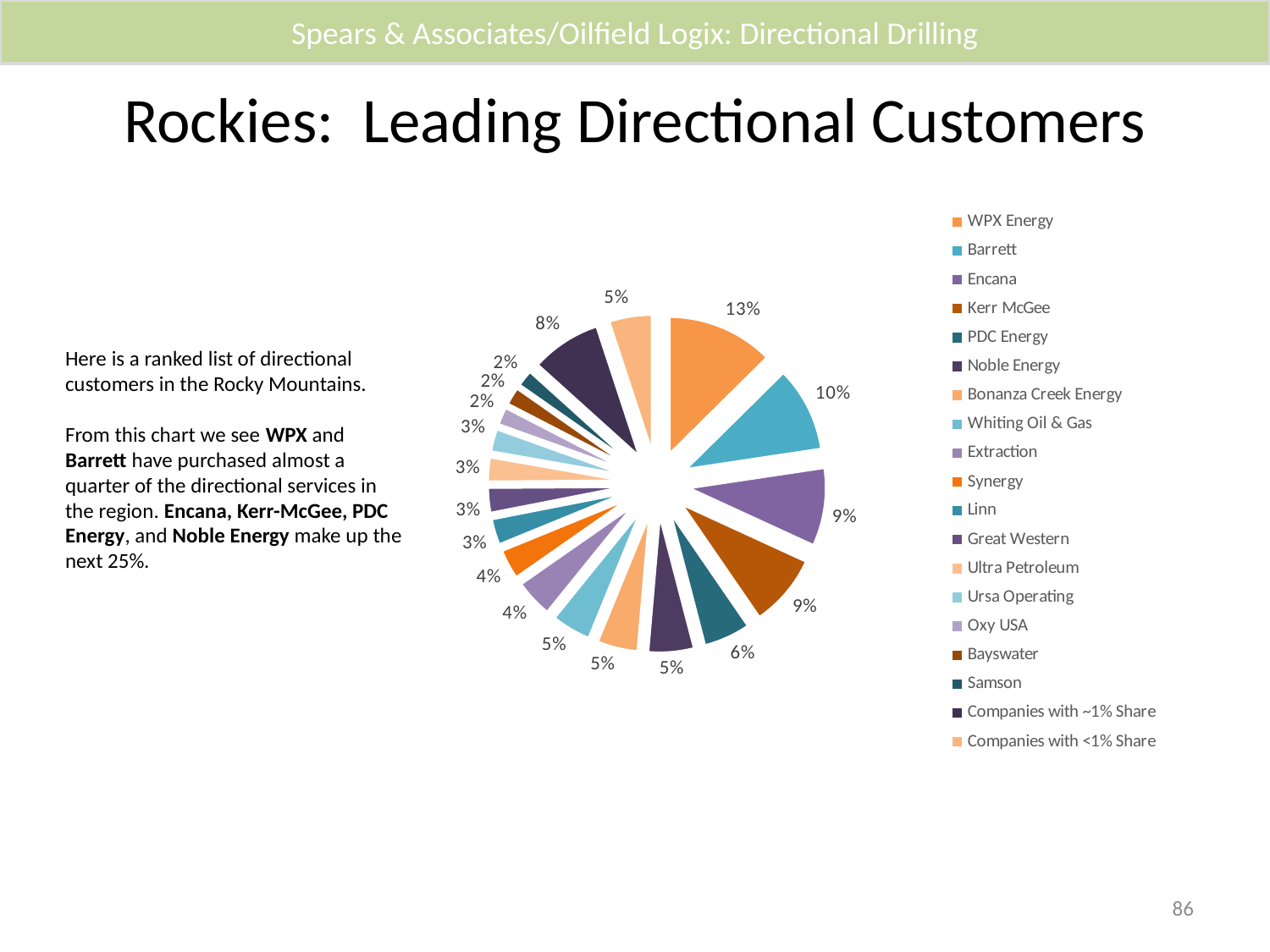
Which company has the largest slice of the pie? WPX Energy What share of the pie does WPX Energy hold? 13% What is the difference between the shares of WPX Energy and Barrett? 3% What share of the pie does Barrett hold? 10% How many entries does the legend list? 19 What share of the pie does Companies with ~1% Share hold? 8% What type of chart is shown on the slide? pie chart What is the combined share of WPX Energy and Barrett? 23% What is the title of the slide containing the pie chart? Rockies: Leading Directional Customers What share of the pie does PDC Energy hold? 6% Which is larger, the share for Encana or the share for PDC Energy? Encana What share of the pie does Extraction hold? 4%